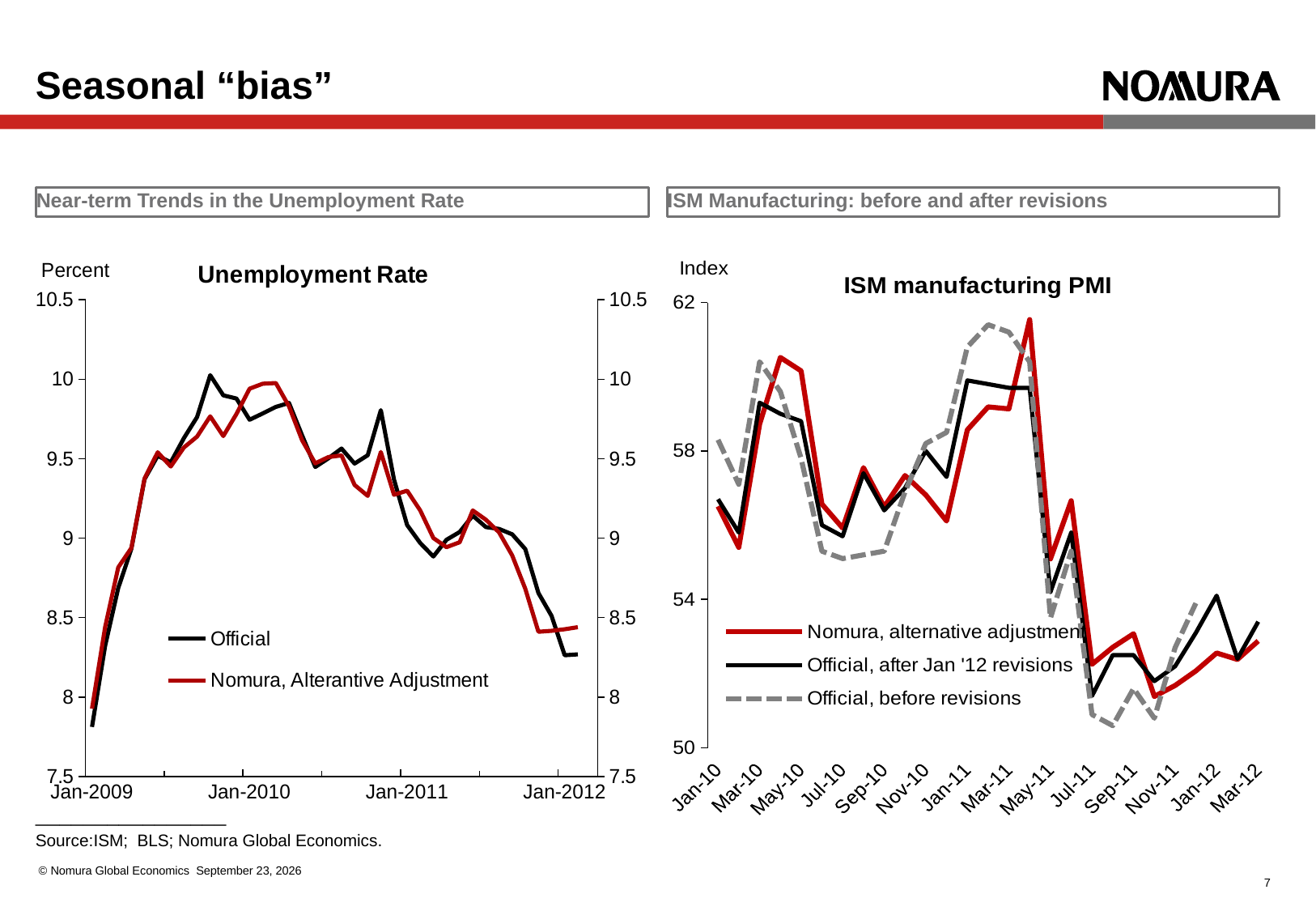
In the 'Unemployment Rate' chart, is the Official value at Jan-2009 greater or less than 8? less What kind of chart is the 'ISM manufacturing PMI' chart on the right? line chart How many series does the legend of the 'Unemployment Rate' chart list? 2 In the 'Unemployment Rate' chart, does the Official series rise or fall between Jan-2011 and Jan-2012? fall In the 'Unemployment Rate' chart, is the Official value at Jan-2012 greater or less than 8.5? less In the 'ISM manufacturing PMI' chart, which series is drawn as a grey dashed line? Official, before revisions In the 'ISM manufacturing PMI' chart, is the peak of the 'Nomura, alternative adjustment' series around May-11 greater or less than 60? greater In the 'Unemployment Rate' chart, which series is drawn in red? Nomura, Alterantive Adjustment What kind of chart is the 'Unemployment Rate' chart on the left? line chart In the 'ISM manufacturing PMI' chart, does the 'Official, after Jan '12 revisions' series rise or fall between Mar-11 and Sep-11? fall How many series does the legend of the 'ISM manufacturing PMI' chart list? 3